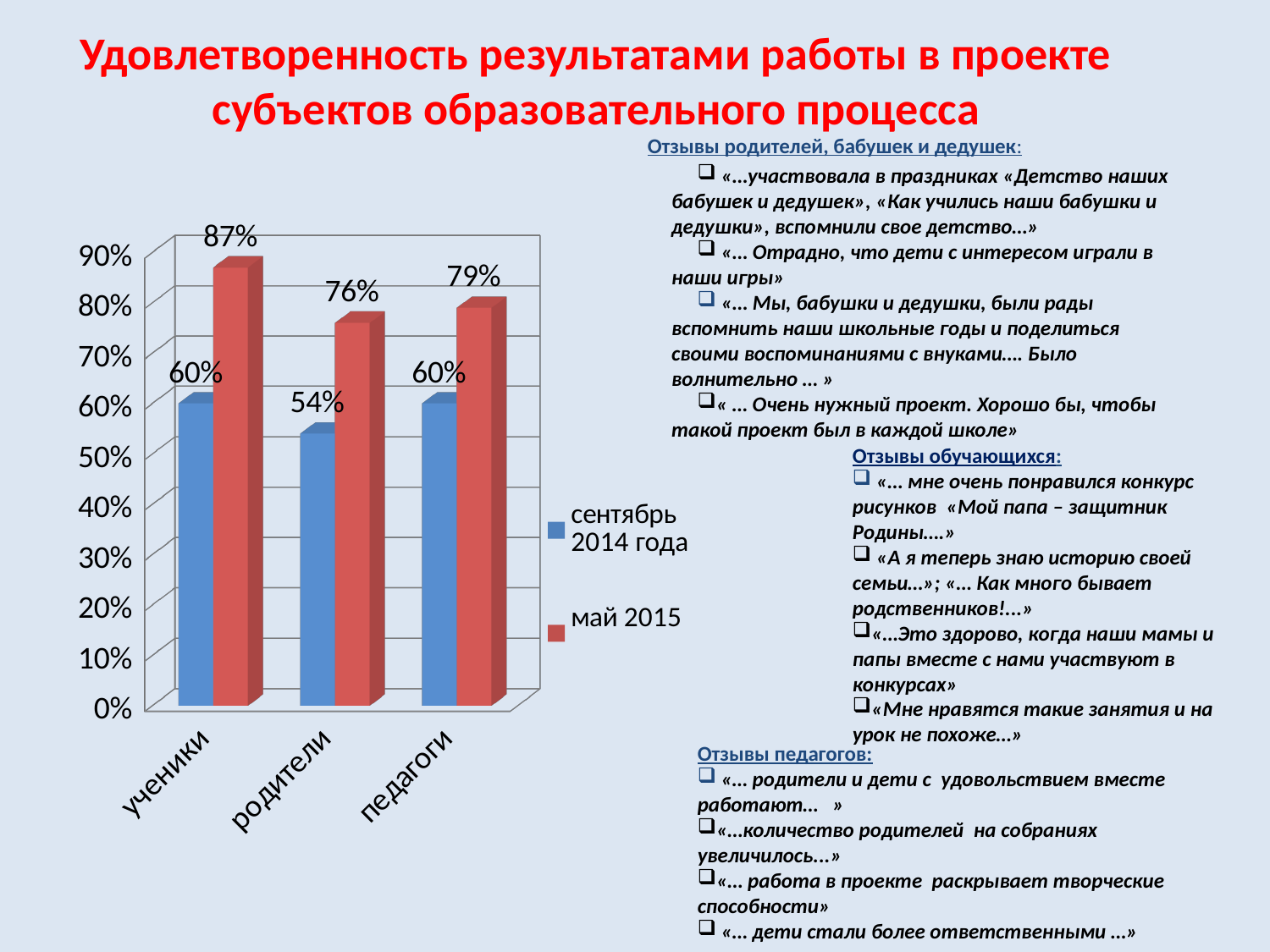
What is the value for родители in the сентябрь 2014 года series? 54% Which category has the highest value in the май 2015 series? ученики What is the value for педагоги in the май 2015 series? 79% Which category has the lowest value in the сентябрь 2014 года series? родители What is the value for ученики in the май 2015 series? 87% How many series does the legend list? 2 Is the май 2015 value for родители greater or less than 70%? greater What is the difference between the май 2015 and сентябрь 2014 года values for родители? 22% How many categories are shown on the x axis? 3 What is the difference between the май 2015 and сентябрь 2014 года values for ученики? 27% What kind of chart is shown on the slide? bar chart Which is larger for педагоги: the сентябрь 2014 года value or the май 2015 value? май 2015